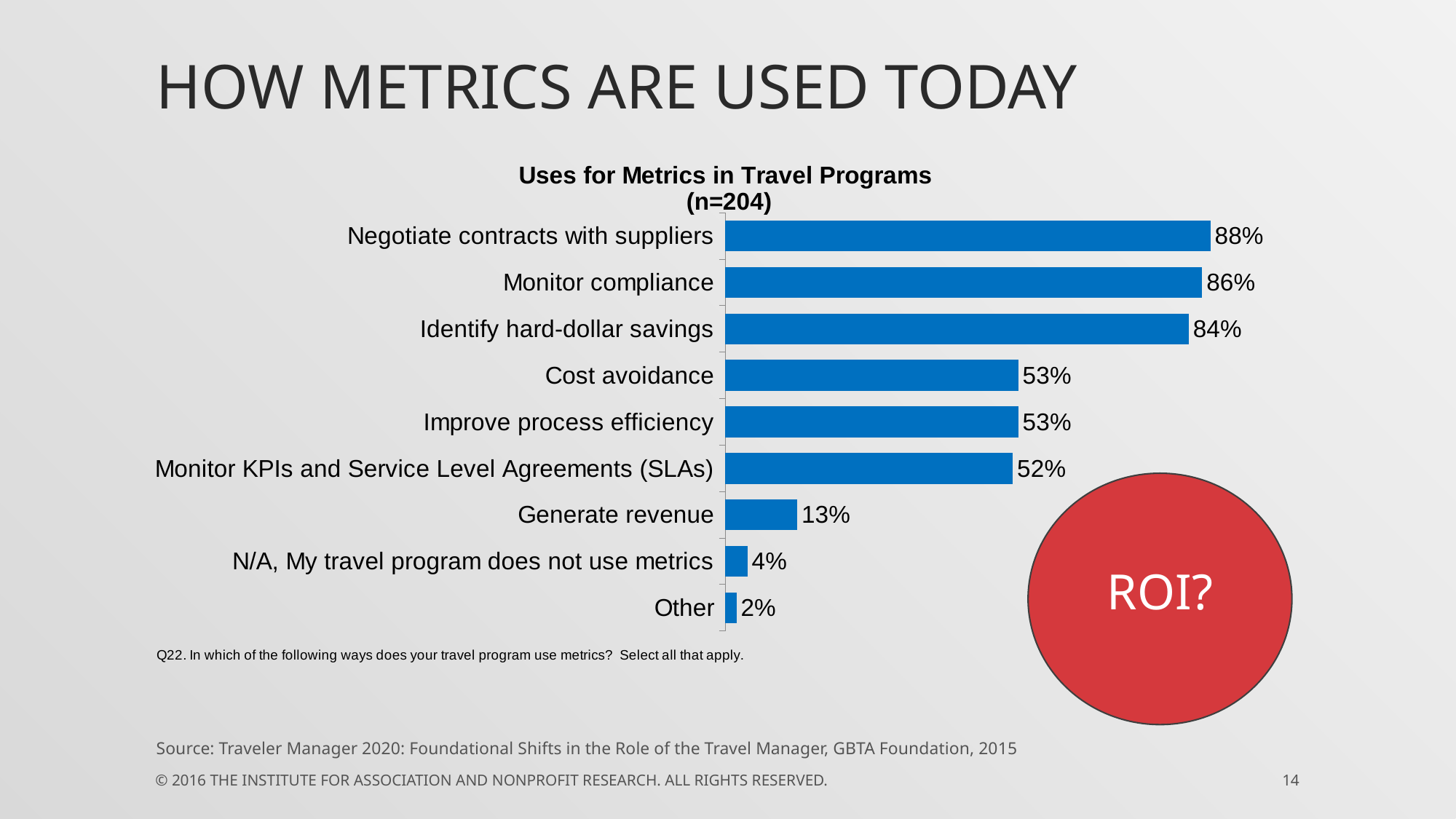
Which is larger: the value for Monitor KPIs and Service Level Agreements (SLAs) or the value for Generate revenue? Monitor KPIs and Service Level Agreements (SLAs) What percentage of respondents use metrics to negotiate contracts with suppliers? 88% What is the difference between the values for Identify hard-dollar savings and Cost avoidance? 31% Which category has the highest value in the chart? Negotiate contracts with suppliers What percentage is shown for Generate revenue? 13% What is the title of the chart? Uses for Metrics in Travel Programs (n=204) What is the value shown for Monitor compliance? 86% What is the value for 'N/A, My travel program does not use metrics'? 4% How many categories are shown in the chart? 9 What is the sample size (n) stated in the chart title? 204 Which category has the lowest value in the chart? Other What kind of chart is shown on the slide? Bar chart